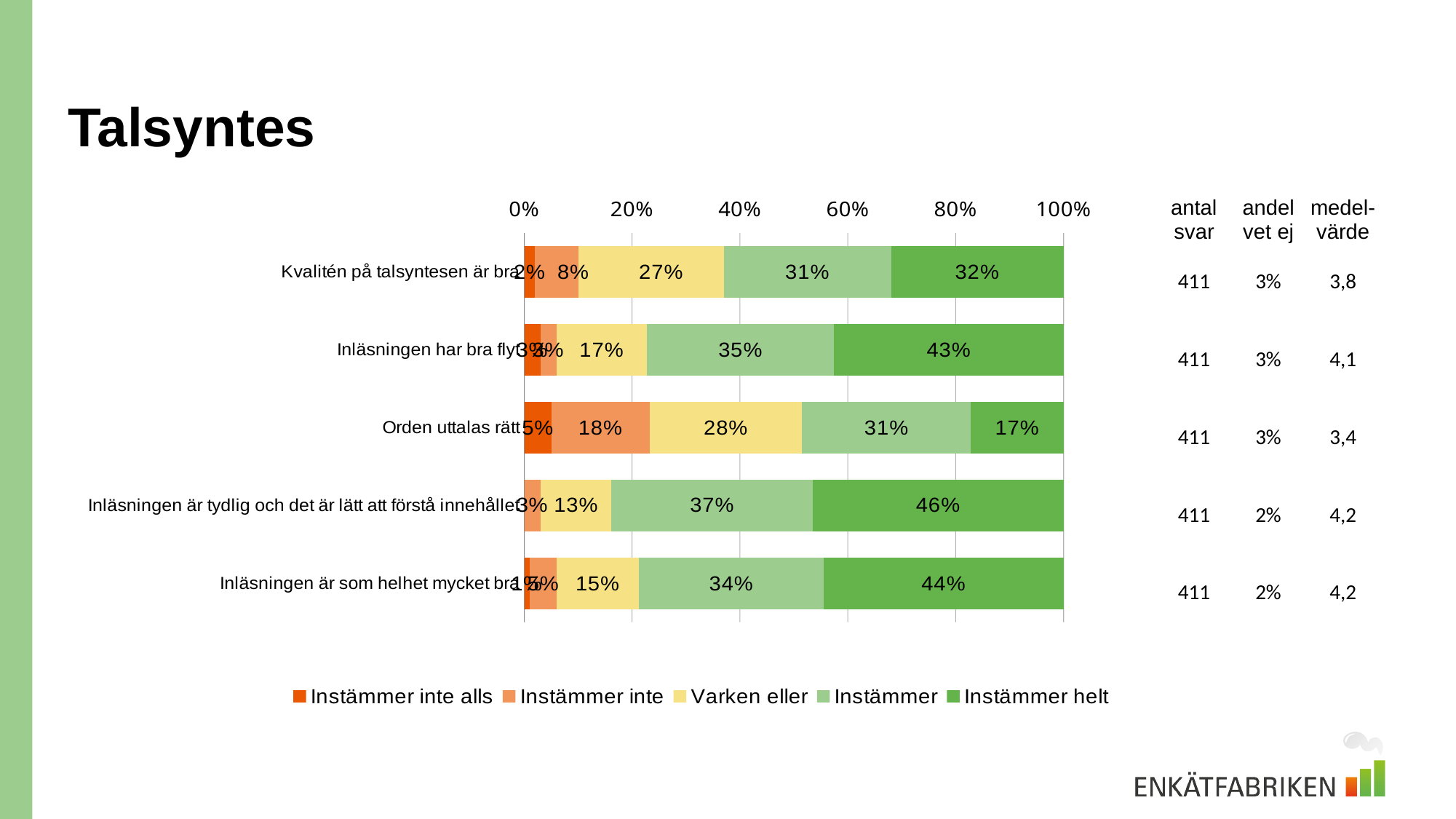
What kind of chart is shown on the slide? Stacked bar chart How many statements (categories) are plotted in the chart? 5 Which statement has the lowest 'Instämmer helt' share? Orden uttalas rätt Which statement has the highest 'Instämmer helt' share? Inläsningen är tydlig och det är lätt att förstå innehållet What is the 'Instämmer inte' value for 'Orden uttalas rätt'? 18% What is the title of the slide containing the chart? Talsyntes What is the difference in 'Instämmer helt' between 'Inläsningen är tydlig och det är lätt att förstå innehållet' and 'Orden uttalas rätt'? 29 percentage points How many series does the legend list? 5 What is the 'Varken eller' value for 'Kvalitén på talsyntesen är bra'? 27% What is the 'Instämmer' value for 'Orden uttalas rätt'? 31% Which has a larger 'Instämmer' share: 'Inläsningen är tydlig och det är lätt att förstå innehållet' or 'Kvalitén på talsyntesen är bra'? Inläsningen är tydlig och det är lätt att förstå innehållet What is the 'Instämmer helt' value for 'Inläsningen är tydlig och det är lätt att förstå innehållet'? 46%